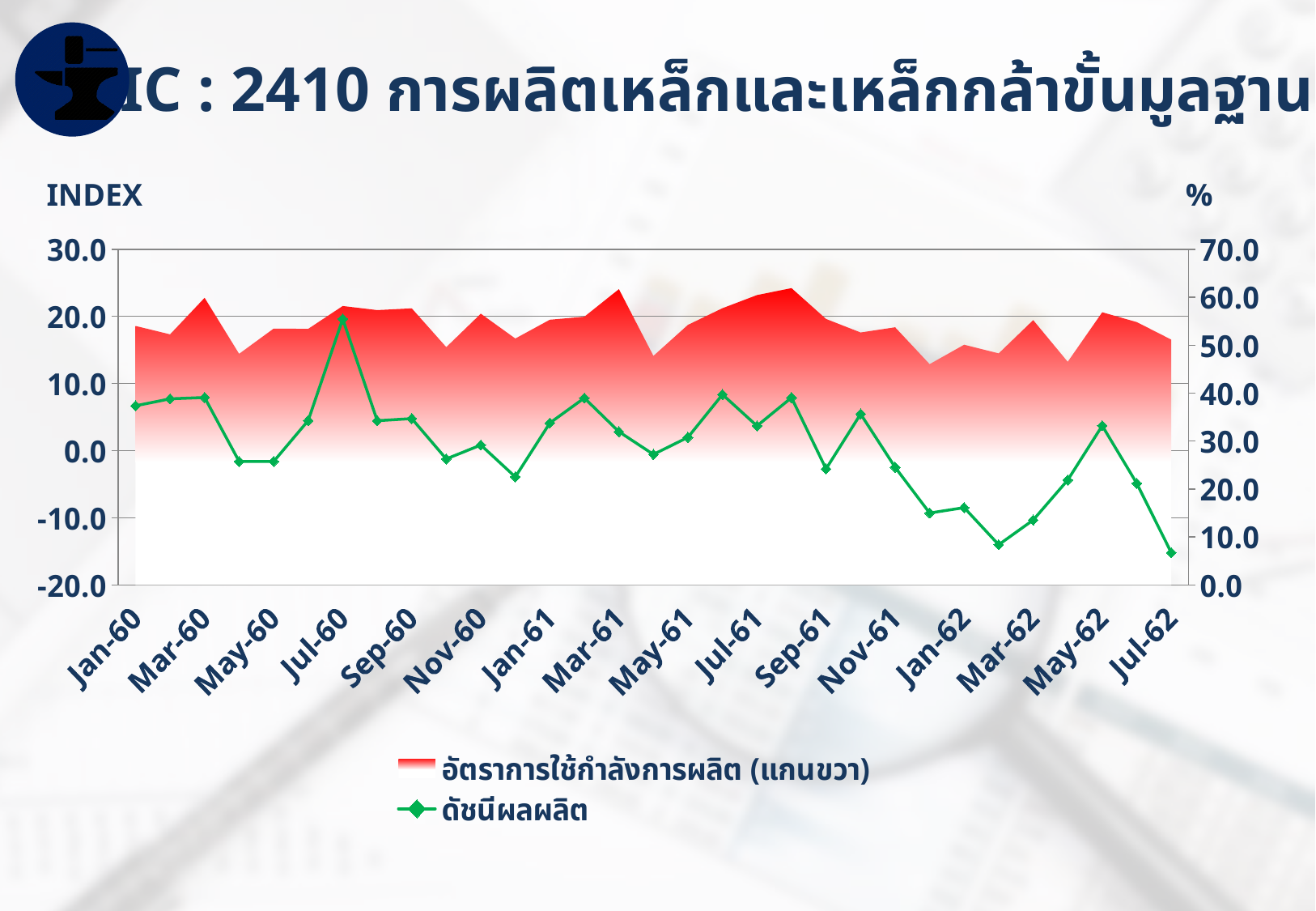
Is the อัตราการใช้กำลังการผลิต value at Jul-60 greater or less than 50.0? greater How many series does the legend list? 2 What is the label of the left vertical axis? INDEX Does the green ดัชนีผลผลิต line overall rise or fall from Jan-60 to Jul-62? fall What kind of chart is shown on the slide? A combination area and line chart At which month does the green ดัชนีผลผลิต line reach its highest value? Jul-60 How many labels are shown on the x axis? 16 Which is larger, the ดัชนีผลผลิต value at Jul-60 or at Jan-62? Jul-60 Is the ดัชนีผลผลิต value at Jul-60 greater or less than 10.0? greater Is the ดัชนีผลผลิต value at Jan-60 greater or less than 0.0? greater